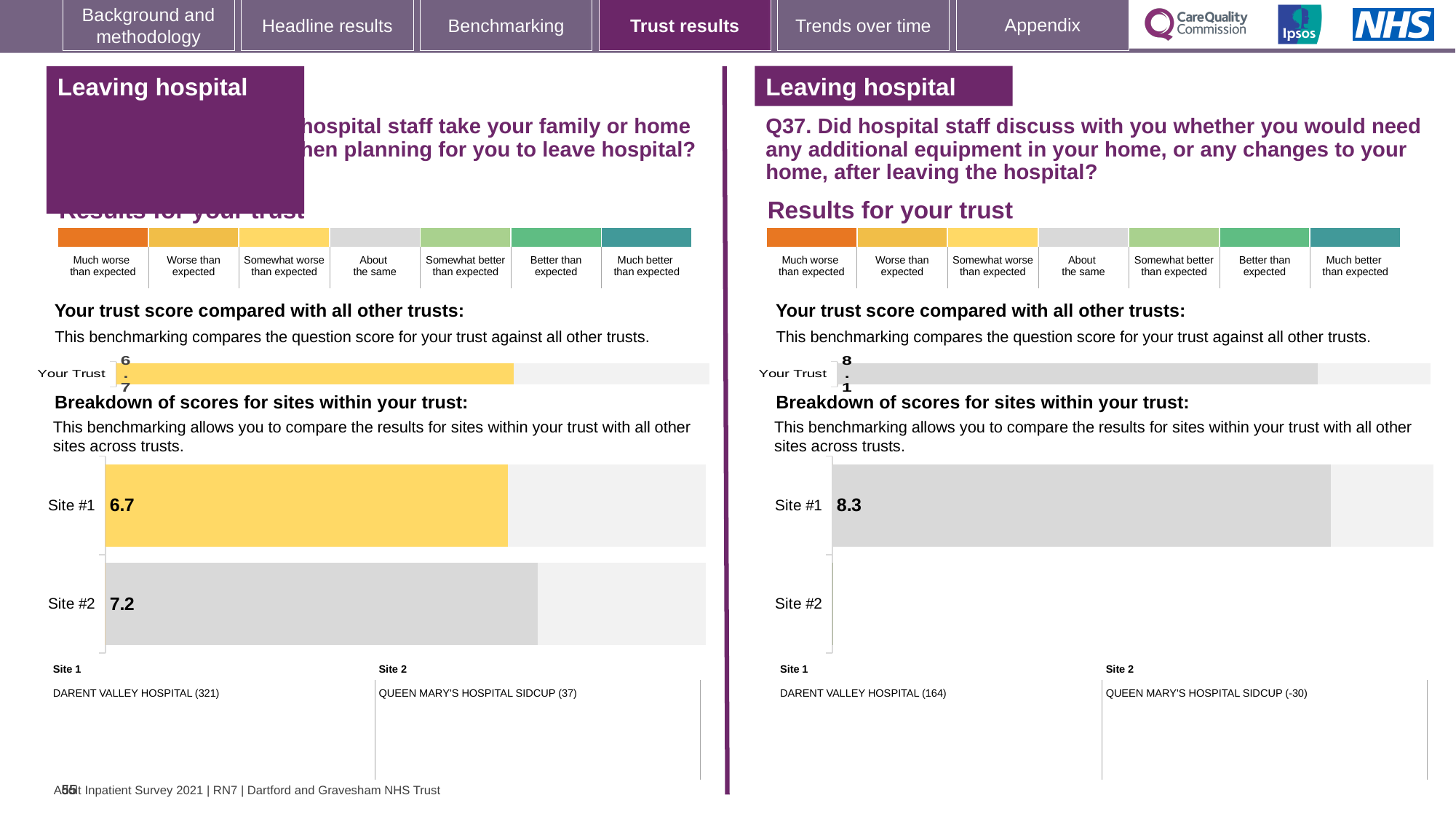
On the left-hand site breakdown chart, what colour is the bar for Site #1? yellow On the left-hand 'Breakdown of scores for sites within your trust' chart, what is the score for Site #2? 7.2 On the left-hand site breakdown chart, what is the difference between the Site #2 and Site #1 scores? 0.5 On the right-hand (Q37) site breakdown chart, what colour is the bar for Site #1? grey On the right-hand (Q37) site breakdown chart, how many sites are listed on the axis? 2 On the right-hand (Q37) 'Breakdown of scores for sites within your trust' chart, what is the score for Site #1? 8.3 On the right-hand (Q37) 'Your trust score compared with all other trusts' chart, what is the score for Your Trust? 8.1 Is the Site #1 score on the right-hand (Q37) site breakdown chart larger or smaller than the Site #1 score on the left-hand site breakdown chart? larger What kind of chart is used for the site breakdown on the left-hand side of the slide? bar chart On the left-hand 'Breakdown of scores for sites within your trust' chart, what is the score for Site #1? 6.7 On the left-hand site breakdown chart, which site has the higher score? Site #2 On the left-hand 'Your trust score compared with all other trusts' chart, what is the score for Your Trust? 6.7